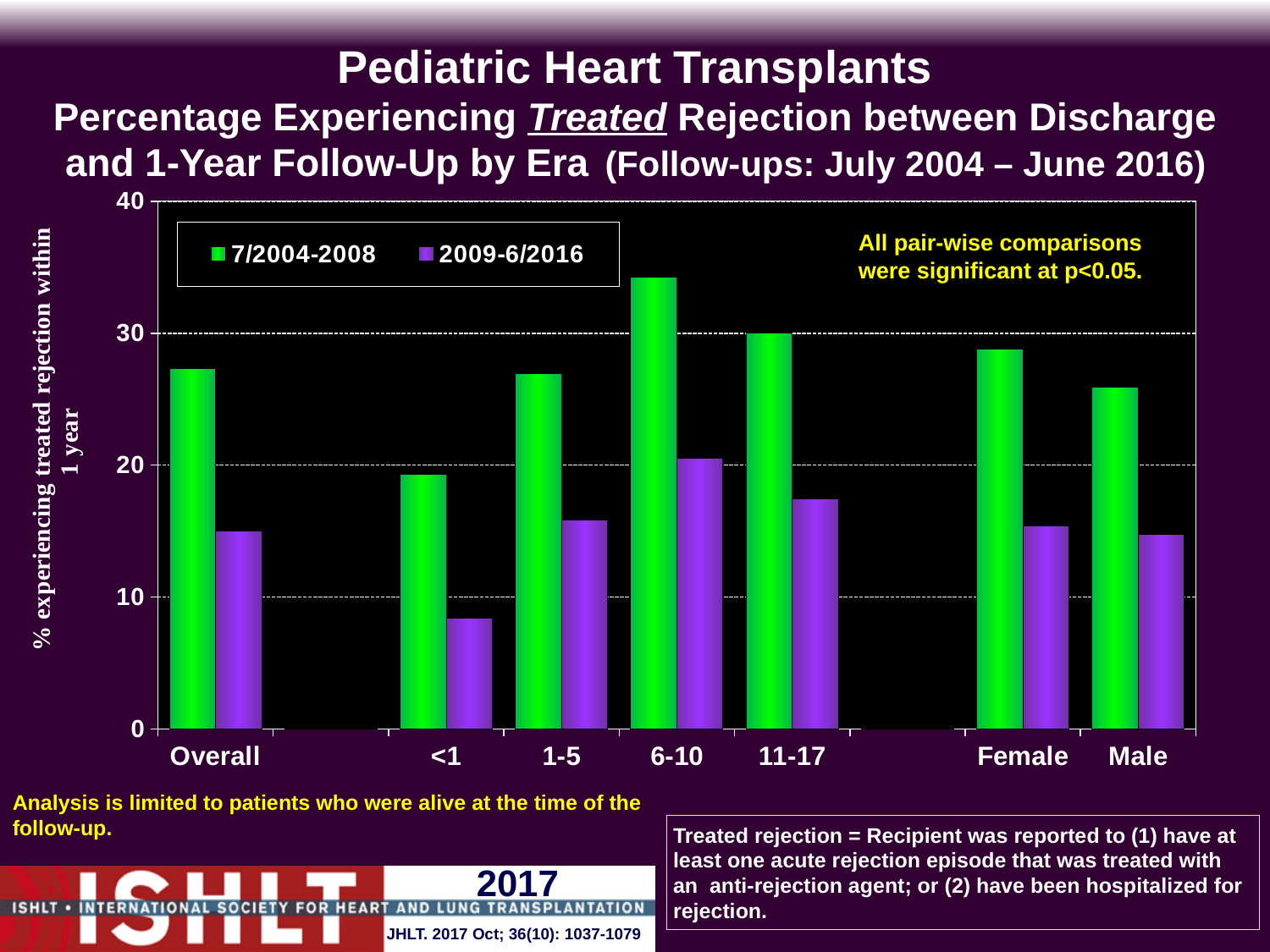
Is the 2009-6/2016 value for 11-17 greater or less than 20? less What colour are the bars for the 2009-6/2016 series? purple Which category has the highest value for the 7/2004-2008 series? 6-10 For the Female category, which era has the larger value, 7/2004-2008 or 2009-6/2016? 7/2004-2008 Is the 2009-6/2016 value for <1 greater or less than 10? less Is the 7/2004-2008 value for Overall greater or less than 20? greater Which is larger for the 7/2004-2008 series, the value for 6-10 or the value for <1? 6-10 What kind of chart is shown on the slide? bar chart Which category has the lowest value for the 2009-6/2016 series? <1 How many categories are shown along the x axis? 7 How many series does the legend list? 2